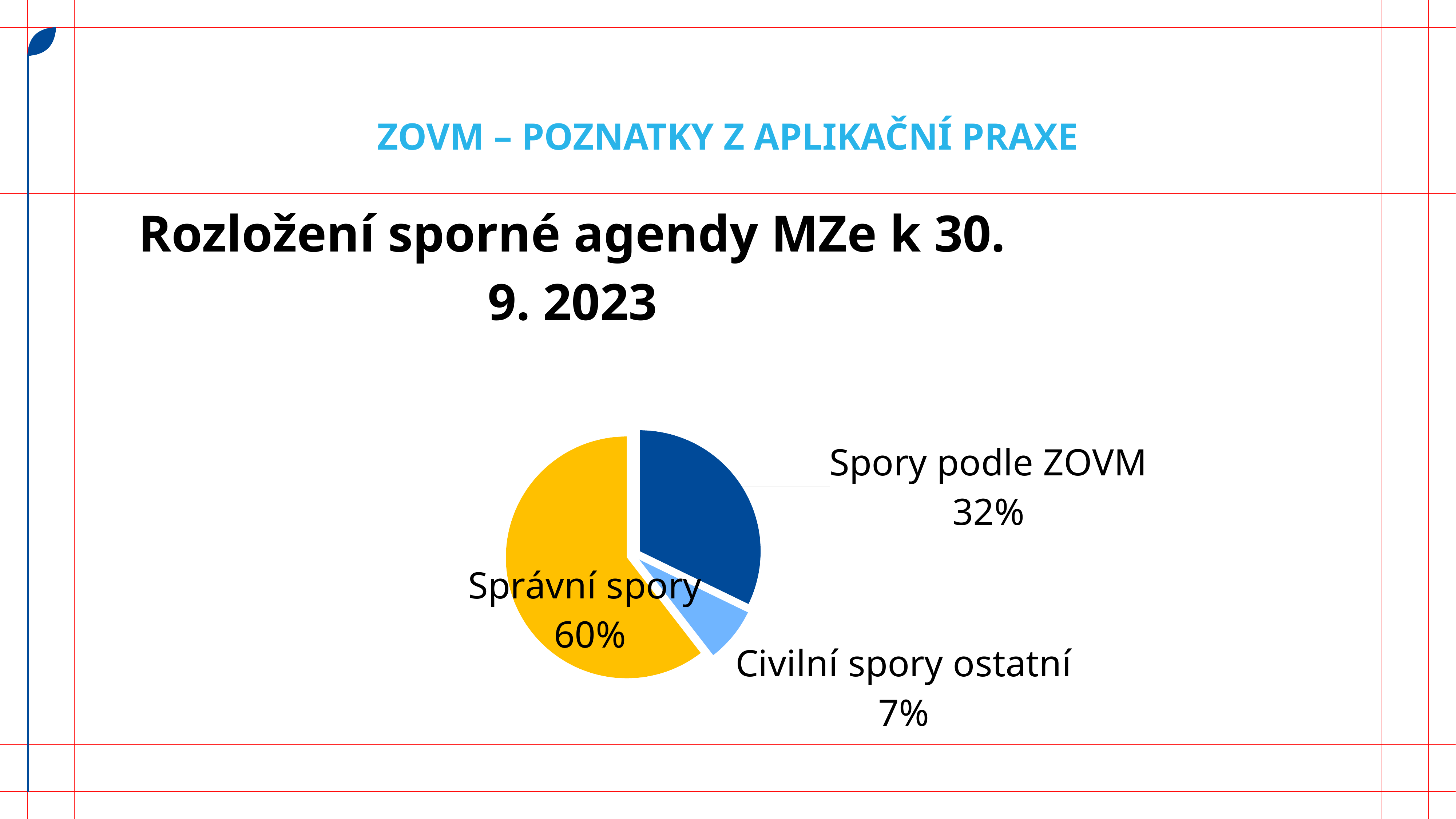
Which category has the smallest slice of the pie? Civilní spory ostatní What share of the pie does Spory podle ZOVM have? 32% What is the title of the chart? Rozložení sporné agendy MZe k 30. 9. 2023 Which is larger, Spory podle ZOVM or Civilní spory ostatní? Spory podle ZOVM What share of the pie does Správní spory have? 60% How many slices does the pie chart have? 3 What kind of chart is shown on the slide? Pie chart Which category has the largest slice of the pie? Správní spory What share of the pie does Civilní spory ostatní have? 7% What colour is the Správní spory slice? Yellow What is the difference in percentage points between Spory podle ZOVM and Civilní spory ostatní? 25 What is the difference in percentage points between Správní spory and Spory podle ZOVM? 28